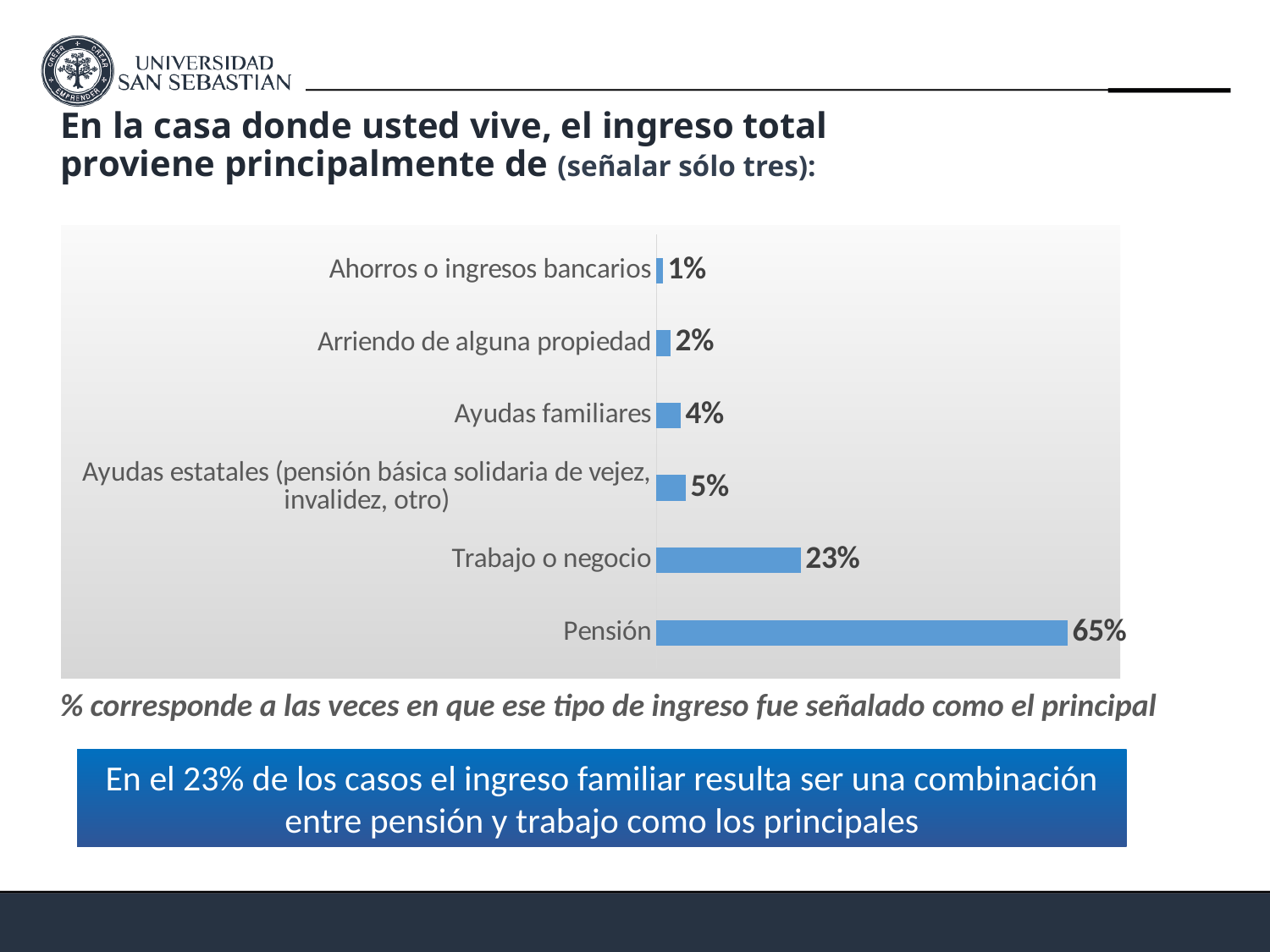
What is the value for Ahorros o ingresos bancarios? 1% What is the difference between the values for Ayudas estatales (pensión básica solidaria de vejez, invalidez, otro) and Arriendo de alguna propiedad? 3% What is the difference between the values for Pensión and Trabajo o negocio? 42% What kind of chart is shown on the slide? Bar chart What is the value for Ayudas familiares? 4% Which category has the highest value? Pensión Which is larger, the value for Ayudas familiares or the value for Arriendo de alguna propiedad? Ayudas familiares Which category has the lowest value? Ahorros o ingresos bancarios What is the value for Trabajo o negocio? 23% What is the value for Ayudas estatales (pensión básica solidaria de vejez, invalidez, otro)? 5% What is the value for Pensión? 65% How many categories are shown in the chart? 6